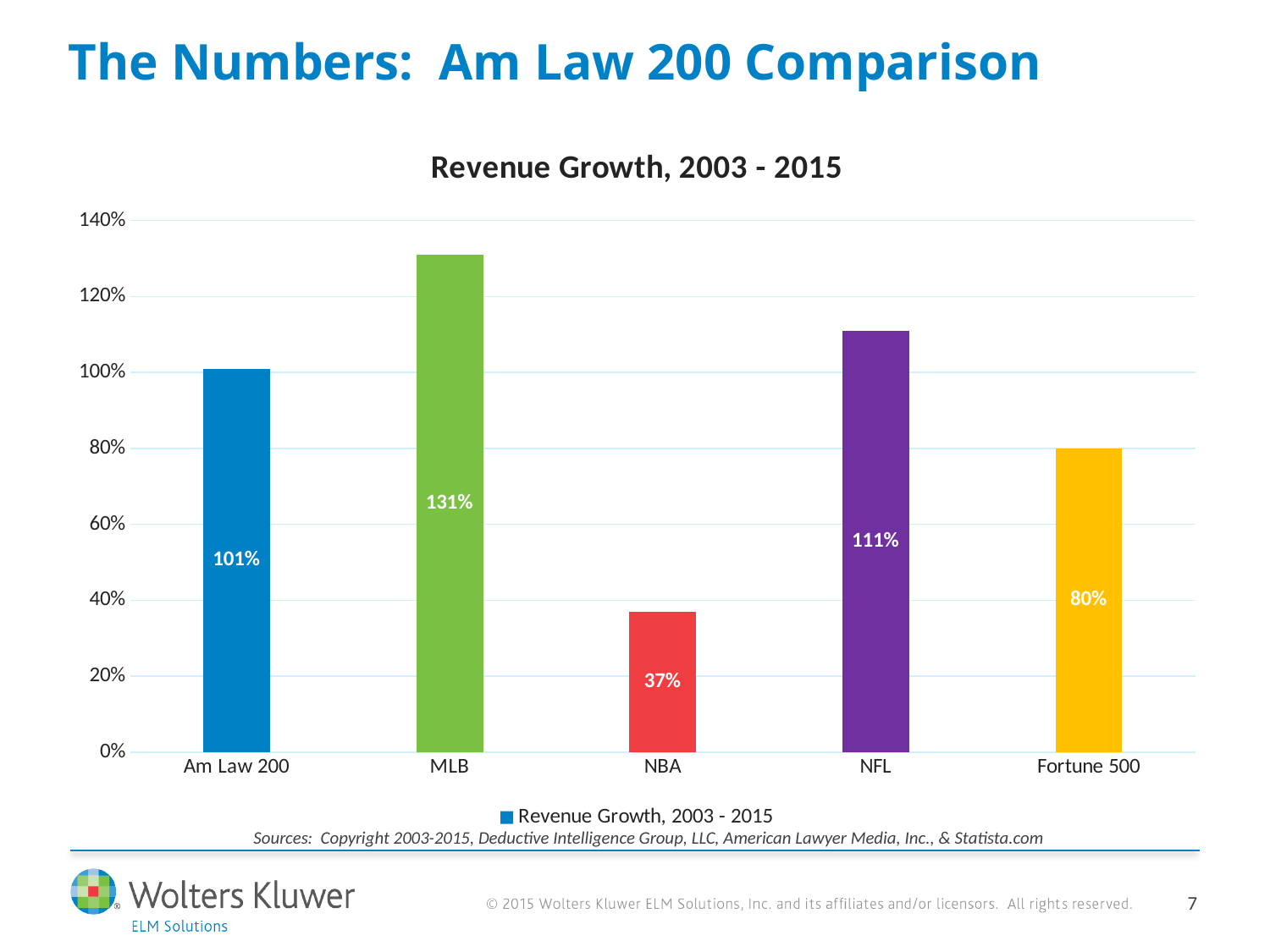
What is the difference between the revenue growth of NFL and Am Law 200? 10% What kind of chart is shown on the slide? Bar chart Is the value for NBA greater or less than 40%? less Which category has the highest revenue growth? MLB What is the revenue growth value for Fortune 500? 80% What is the title of the chart? Revenue Growth, 2003 - 2015 Which category has the lowest revenue growth? NBA How many categories are shown on the chart? 5 What is the revenue growth value for MLB? 131% What is the difference between the revenue growth of MLB and NBA? 94% What is the revenue growth value for Am Law 200? 101% Which has higher revenue growth, NFL or Fortune 500? NFL